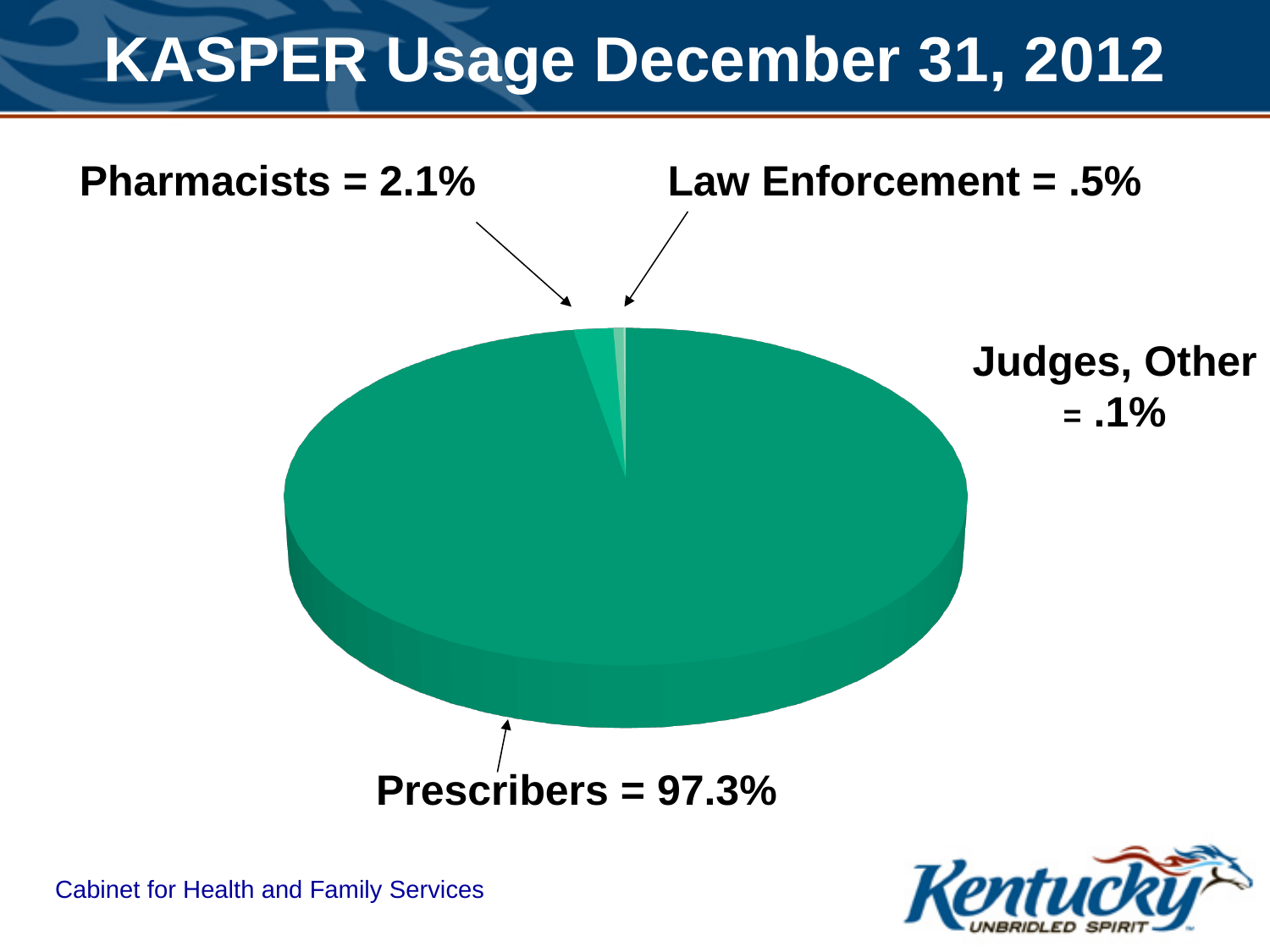
Which user group has the smallest share of KASPER usage? Judges, Other What kind of chart is shown on the slide? Pie chart What is the difference in percentage points between the Prescribers share and the Pharmacists share? 95.2 How many user groups are shown in the pie chart? 4 What share of KASPER usage is attributed to Pharmacists? 2.1% Which group has a larger share of KASPER usage, Pharmacists or Law Enforcement? Pharmacists What share of KASPER usage is attributed to Judges, Other? .1% What share of KASPER usage is attributed to Prescribers? 97.3% Which user group has the largest share of KASPER usage? Prescribers What share of KASPER usage is attributed to Law Enforcement? .5% What is the title of the slide containing the chart? KASPER Usage December 31, 2012 What is the difference in percentage points between the Pharmacists share and the Law Enforcement share? 1.6